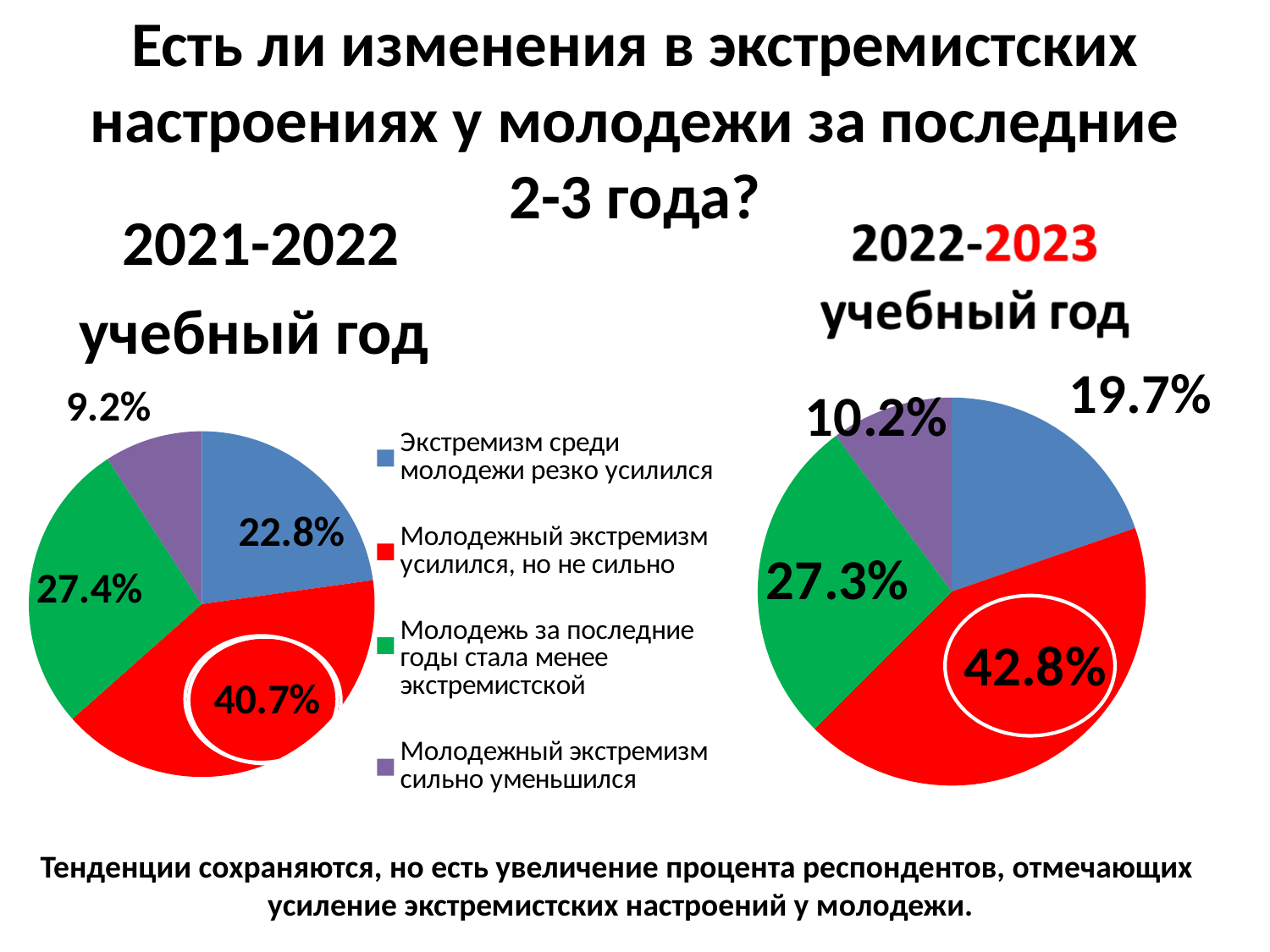
How many entries does the legend list? 4 On the 2022-2023 учебный год pie chart, what share is shown for the green slice (Молодежь за последние годы стала менее экстремистской)? 27.3% What is the difference between the red slice on the 2022-2023 pie chart (42.8%) and the red slice on the 2021-2022 pie chart (40.7%)? 2.1% On the 2021-2022 учебный год pie chart, which category has the largest share? Молодежный экстремизм усилился, но не сильно On the 2022-2023 учебный год pie chart, which category has the smallest share? Молодежный экстремизм сильно уменьшился Which colour represents the category 'Молодежь за последние годы стала менее экстремистской' in the legend? Green What type of chart is used on this slide? Pie chart On the 2021-2022 учебный год pie chart, what share is shown for the purple slice (Молодежный экстремизм сильно уменьшился)? 9.2% On the 2021-2022 учебный год pie chart, what share is shown for the red slice (Молодежный экстремизм усилился, но не сильно)? 40.7% On the 2022-2023 учебный год pie chart, what share is shown for the blue slice (Экстремизм среди молодежи резко усилился)? 19.7% How many slices does the 2022-2023 учебный год pie chart have? 4 Which is larger: the blue slice on the 2021-2022 pie chart or the blue slice on the 2022-2023 pie chart? 2021-2022 (22.8%)